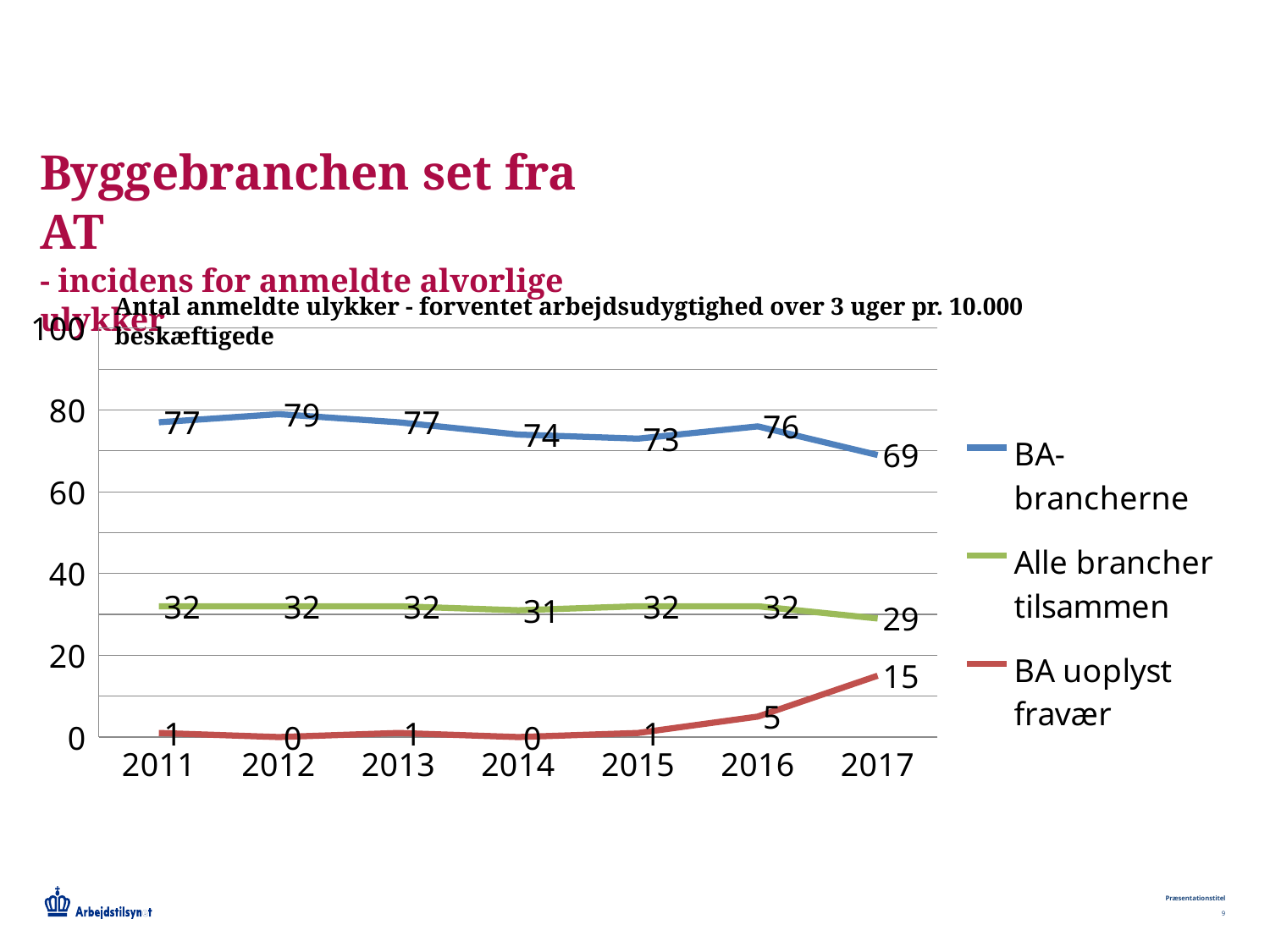
In which year is the value for BA-brancherne highest? 2012 What is the difference between the BA-brancherne value in 2011 and in 2017? 8 In which year is the value for BA-brancherne lowest? 2017 How many years are shown on the x axis? 7 What kind of chart is shown on the slide? Line chart Which is larger in 2014: the value for BA-brancherne or the value for Alle brancher tilsammen? BA-brancherne What is the value for BA uoplyst fravær in 2016? 5 How many series does the legend list? 3 Which colour is used for the BA uoplyst fravær series? Red Does the value for BA uoplyst fravær rise or fall from 2015 to 2017? Rise What is the value for Alle brancher tilsammen in 2017? 29 What is the value for BA-brancherne in 2012? 79